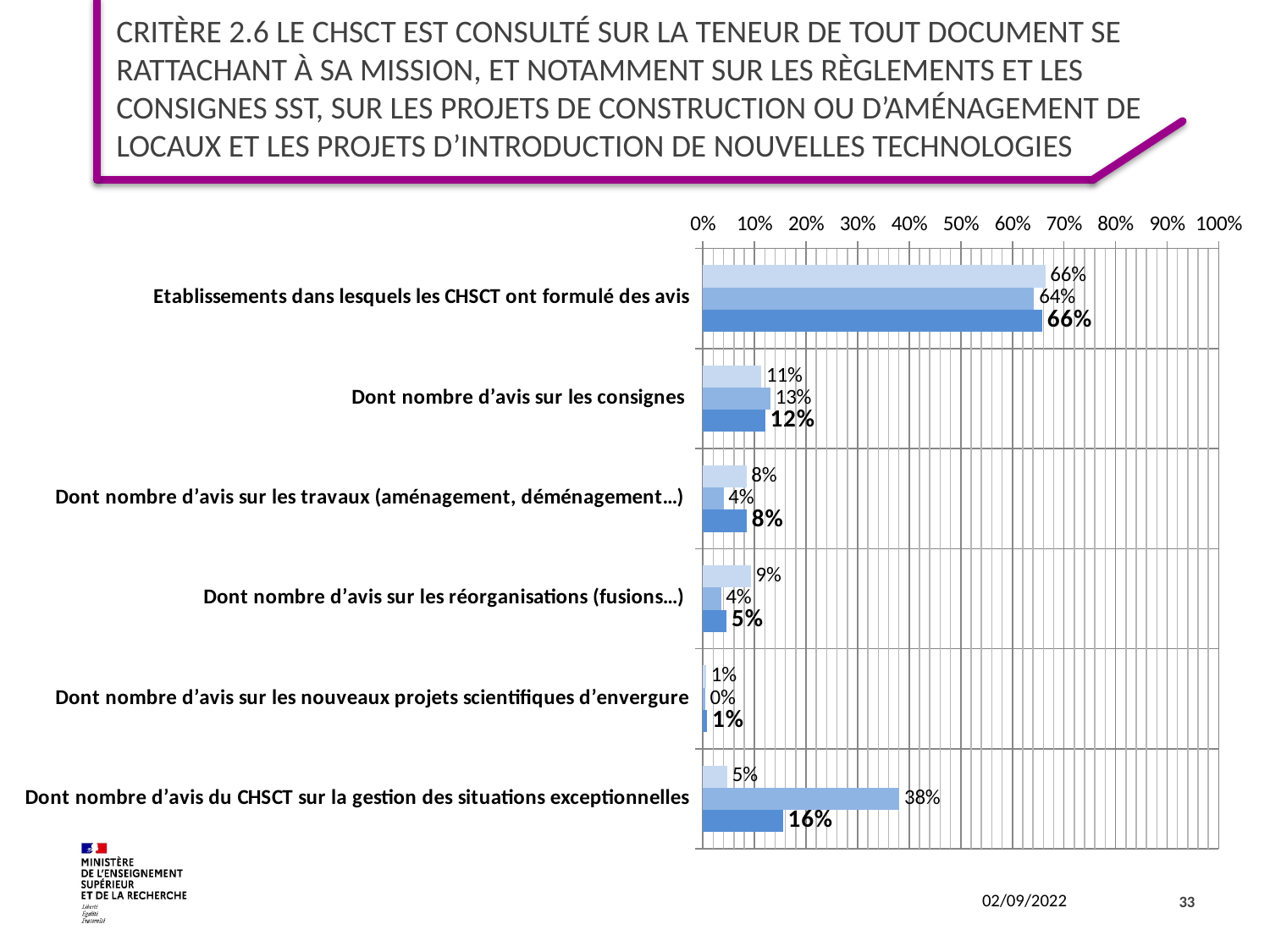
What is the difference between the middle (medium blue) bar and the bottom (dark blue) bar for "Dont nombre d'avis du CHSCT sur la gestion des situations exceptionnelles"? 22% How many categories are shown on the chart? 6 Which category has the lowest values across all bars? Dont nombre d'avis sur les nouveaux projets scientifiques d'envergure Which category has the highest values across all bars? Etablissements dans lesquels les CHSCT ont formulé des avis How many bars are shown for each category? 3 What is the value of the top (light blue) bar for "Dont nombre d'avis sur les consignes"? 11% For "Dont nombre d'avis sur les consignes", which is larger: the middle (medium blue) bar or the top (light blue) bar? the middle (medium blue) bar What type of chart is shown on the slide? bar chart What is the value of the bottom (dark blue, bold-labelled) bar for "Dont nombre d'avis sur les réorganisations (fusions...)"? 5% What is the value of the middle (medium blue) bar for "Dont nombre d'avis du CHSCT sur la gestion des situations exceptionnelles"? 38% What is the value of the bottom (dark blue, bold-labelled) bar for "Etablissements dans lesquels les CHSCT ont formulé des avis"? 66% Is the bottom (dark blue) bar for "Etablissements dans lesquels les CHSCT ont formulé des avis" greater or less than 50%? greater